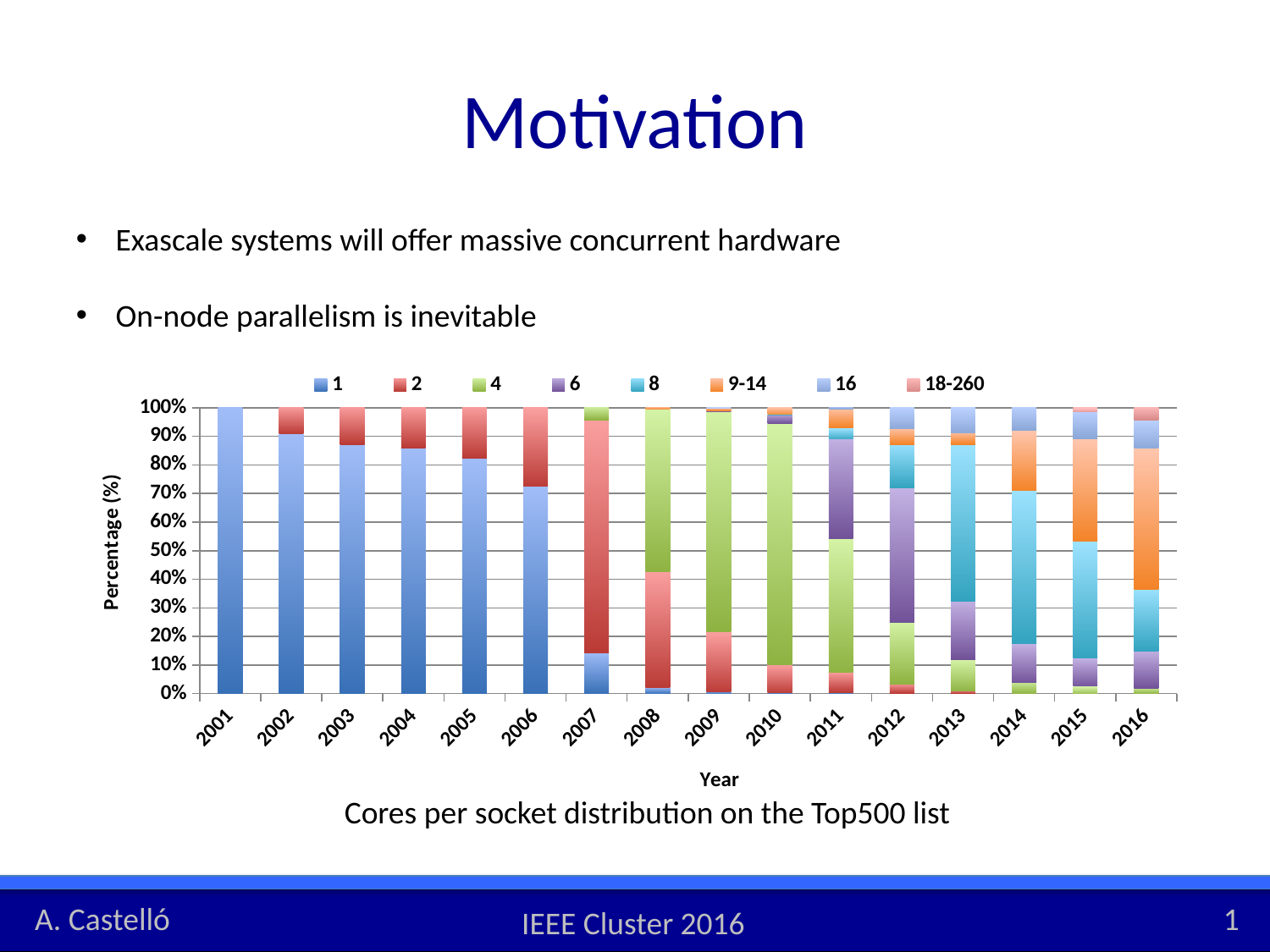
Does the share of the '1' series rise or fall from 2001 to 2006? fall What kind of chart is shown on the slide? bar chart What is the title of the y axis? Percentage (%) What is the value for the '1' series in 2001? 100% Which is larger, the '1' series share in 2002 or in 2006? 2002 Is the value for the '1' series in 2006 greater or less than 70%? greater Is the value for the '8' series in 2015 greater or less than 30%? greater Is the value for the '1' series in 2003 greater or less than 80%? greater What is the title of the x axis? Year Which year has the highest share for the '1' series? 2001 How many years are shown along the x axis? 16 How many series does the legend list? 8